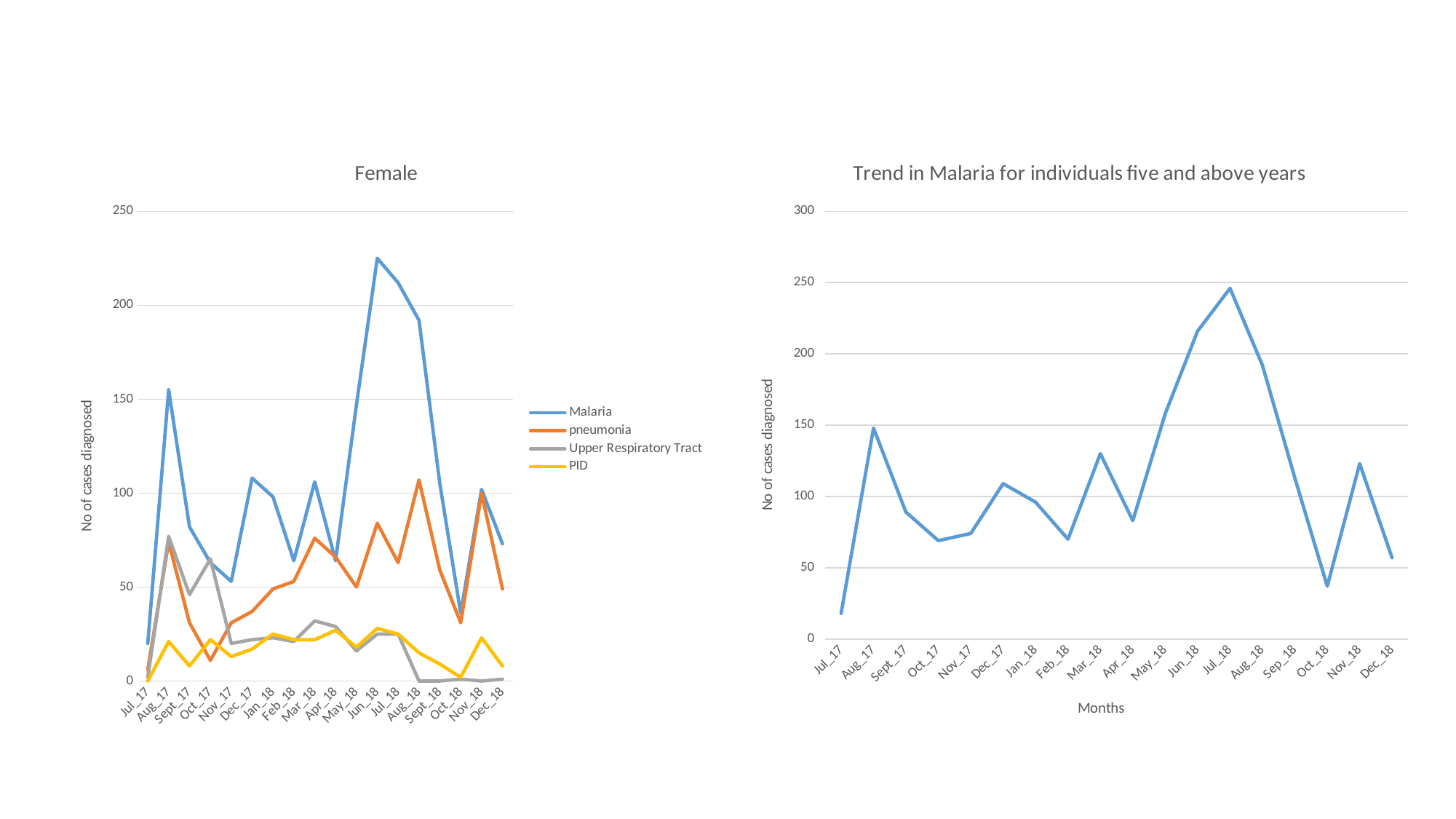
In the 'Female' chart, which series has the larger value in Jun_18, Malaria or pneumonia? Malaria In the 'Female' chart, is the Malaria value for Oct_18 greater or less than 50? less What kind of chart is the 'Female' chart on the left? line chart In the 'Trend in Malaria for individuals five and above years' chart, is the value for Oct_18 greater or less than 50? less In the 'Female' chart, is the Malaria value for Jun_18 greater or less than 200? greater In the 'Trend in Malaria for individuals five and above years' chart, which month has the lowest value? Jul_17 How many months are plotted along the x axis of the 'Trend in Malaria for individuals five and above years' chart? 18 In the 'Trend in Malaria for individuals five and above years' chart, which month has the larger value, Aug_17 or Oct_18? Aug_17 In the 'Trend in Malaria for individuals five and above years' chart, which month has the highest value? Jul_18 How many series does the legend of the 'Female' chart list? 4 What is the y-axis title of the 'Trend in Malaria for individuals five and above years' chart? No of cases diagnosed In the 'Female' chart, in which month does the Malaria series reach its highest value? Jun_18